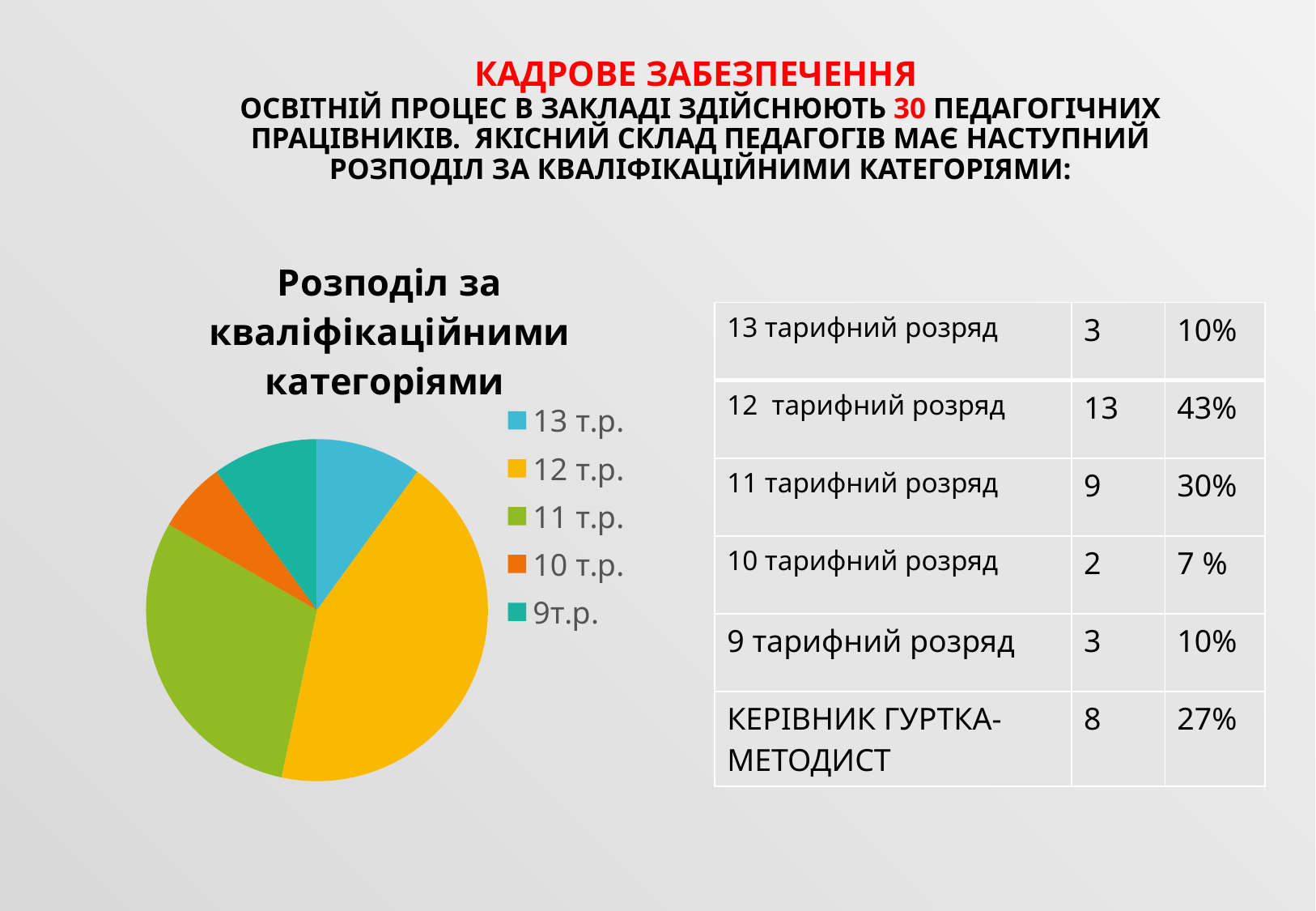
According to the table next to the pie chart, what share do the 12 тарифний розряд teachers make up? 43% According to the table next to the pie chart, how many teachers have the 11 тарифний розряд? 9 In the pie chart, which slice is larger: 12 т.р. or 11 т.р.? 12 т.р. Which category has the largest slice in the pie chart? 12 т.р. What kind of chart is shown on the slide? pie chart According to the table next to the pie chart, what is the difference between the number of teachers with 12 тарифний розряд and 13 тарифний розряд? 10 How many entries does the pie chart's legend list? 5 In the pie chart, which slice is larger: 11 т.р. or 13 т.р.? 11 т.р. Which category has the smallest slice in the pie chart? 10 т.р. What is the title of the pie chart? Розподіл за кваліфікаційними категоріями What colour is the 12 т.р. slice in the pie chart? yellow How many slices does the pie chart have? 5